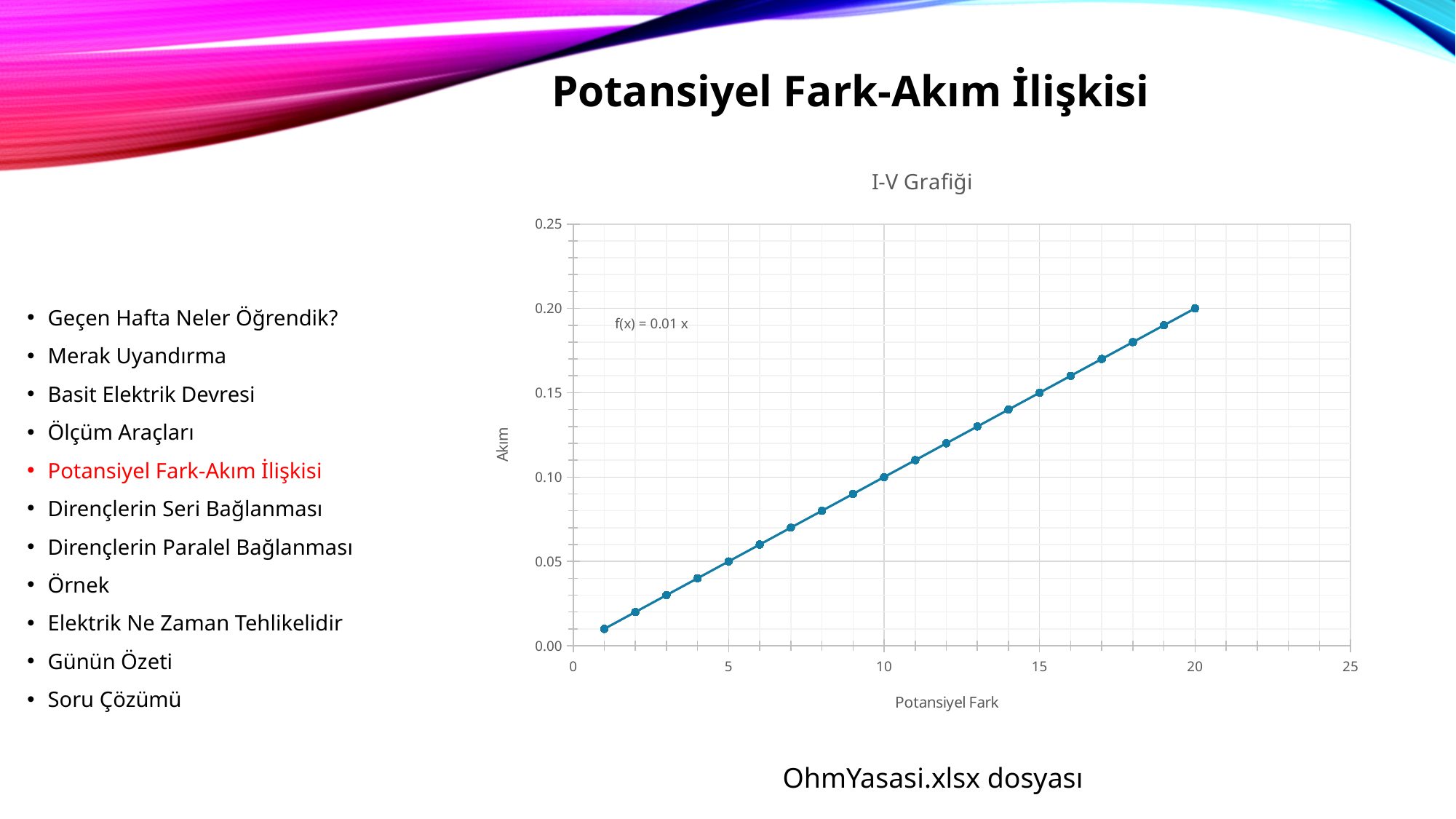
What is the Akım value when Potansiyel Fark is 10? 0.10 At which Potansiyel Fark value is Akım highest? 20 What is the title of the chart? I-V Grafiği What is the Akım value when Potansiyel Fark is 5? 0.05 Is the Akım value at Potansiyel Fark 8 greater or less than 0.10? less How many data points are plotted on the chart? 20 Is the Akım value at Potansiyel Fark 12 greater or less than 0.10? greater What equation is shown on the chart for the plotted line? f(x) = 0.01 x What kind of chart is shown on the slide? scatter chart What is the Akım value when Potansiyel Fark is 20? 0.20 What is the difference between the Akım value at Potansiyel Fark 20 and at Potansiyel Fark 10? 0.10 Do the Akım values rise or fall as Potansiyel Fark increases? rise